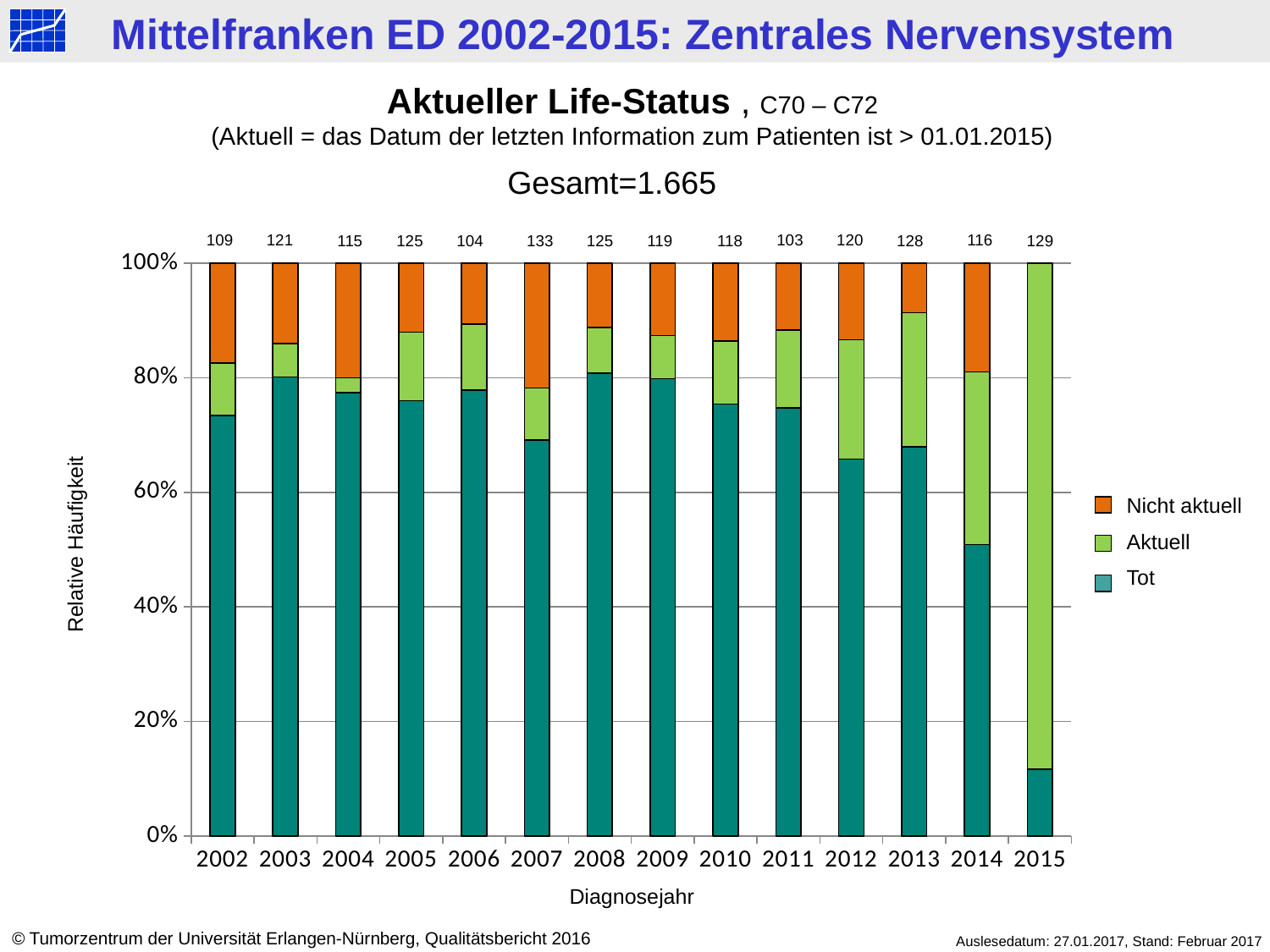
Is the 'Tot' share for 2014 greater or less than 40%? greater How many diagnosis years (categories) are shown on the x axis? 14 Is the 'Tot' share for 2015 greater or less than 20%? less What kind of chart is shown on the slide? stacked bar chart Which diagnosis year has the highest number printed above its bar? 2007 Which diagnosis year has the lowest number printed above its bar? 2011 What is the number printed above the bar for 2007? 133 How many series does the legend list? 3 Which has the larger number printed above its bar, 2013 or 2014? 2013 What is the difference between the numbers printed above the bars for 2007 and 2011? 30 Which legend entry is shown in orange? Nicht aktuell What is the number printed above the bar for 2011? 103